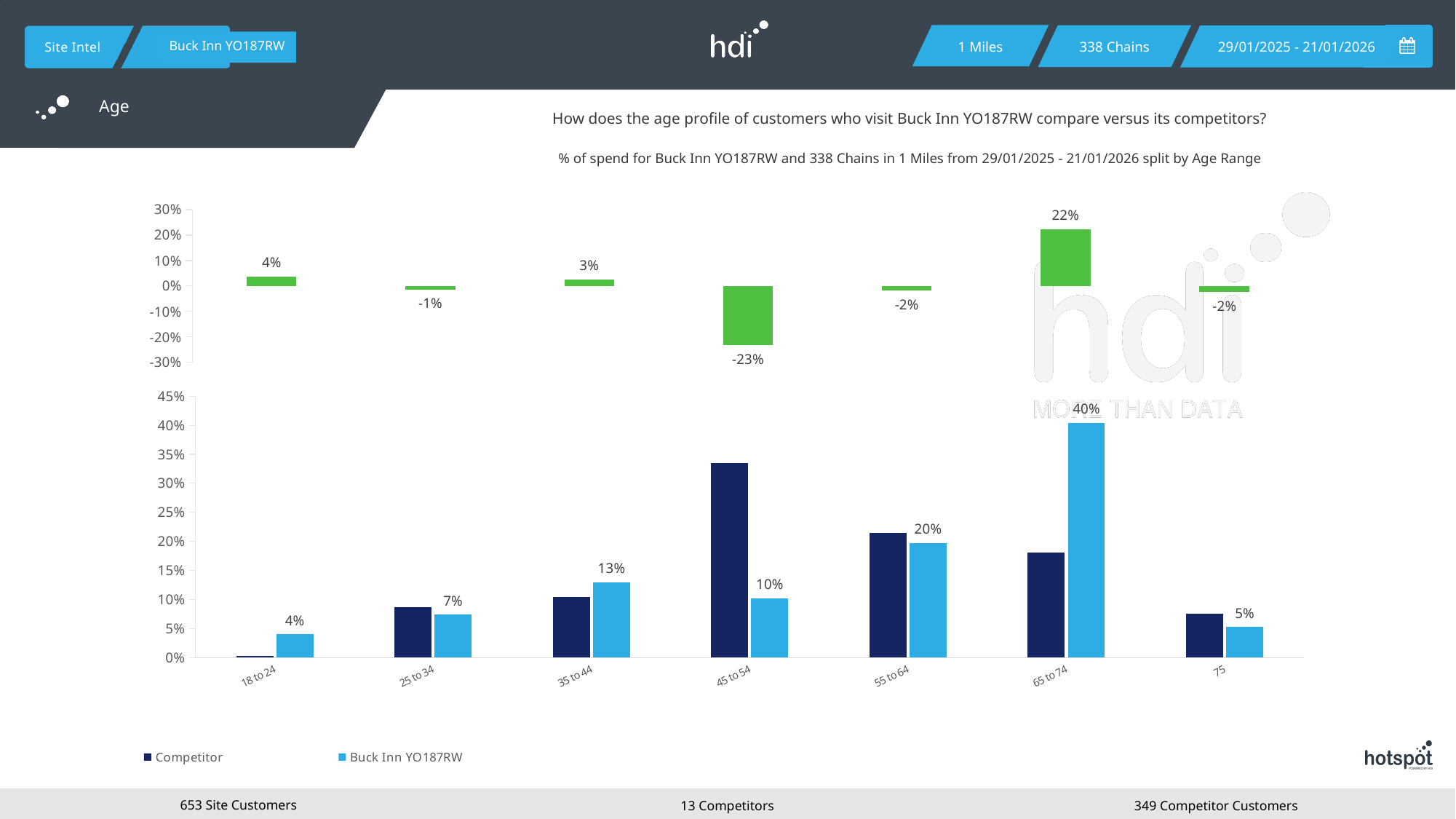
How many series does the legend of the bottom bar chart list? 2 In the bottom bar chart, is the Competitor value for the 45 to 54 age range greater or less than 30%? greater In the top chart of differences, what is the value shown for the 45 to 54 age range? -23% In the top chart of differences, what is the value shown for the 65 to 74 age range? 22% How many age range categories are shown on the x axis of the bottom bar chart? 7 In the bottom bar chart, which age range has the lowest value for Buck Inn YO187RW? 18 to 24 In the bottom bar chart, what is the value for Buck Inn YO187RW in the 65 to 74 age range? 40% In the bottom bar chart, which age range has the highest value for Buck Inn YO187RW? 65 to 74 In the bottom bar chart, which is larger for the 45 to 54 age range: the Competitor bar or the Buck Inn YO187RW bar? Competitor What type of chart is the bottom chart on the slide? Bar chart In the bottom bar chart, what is the value for Buck Inn YO187RW in the 35 to 44 age range? 13% In the bottom bar chart, what is the difference between the Buck Inn YO187RW values for 65 to 74 and 55 to 64? 20%